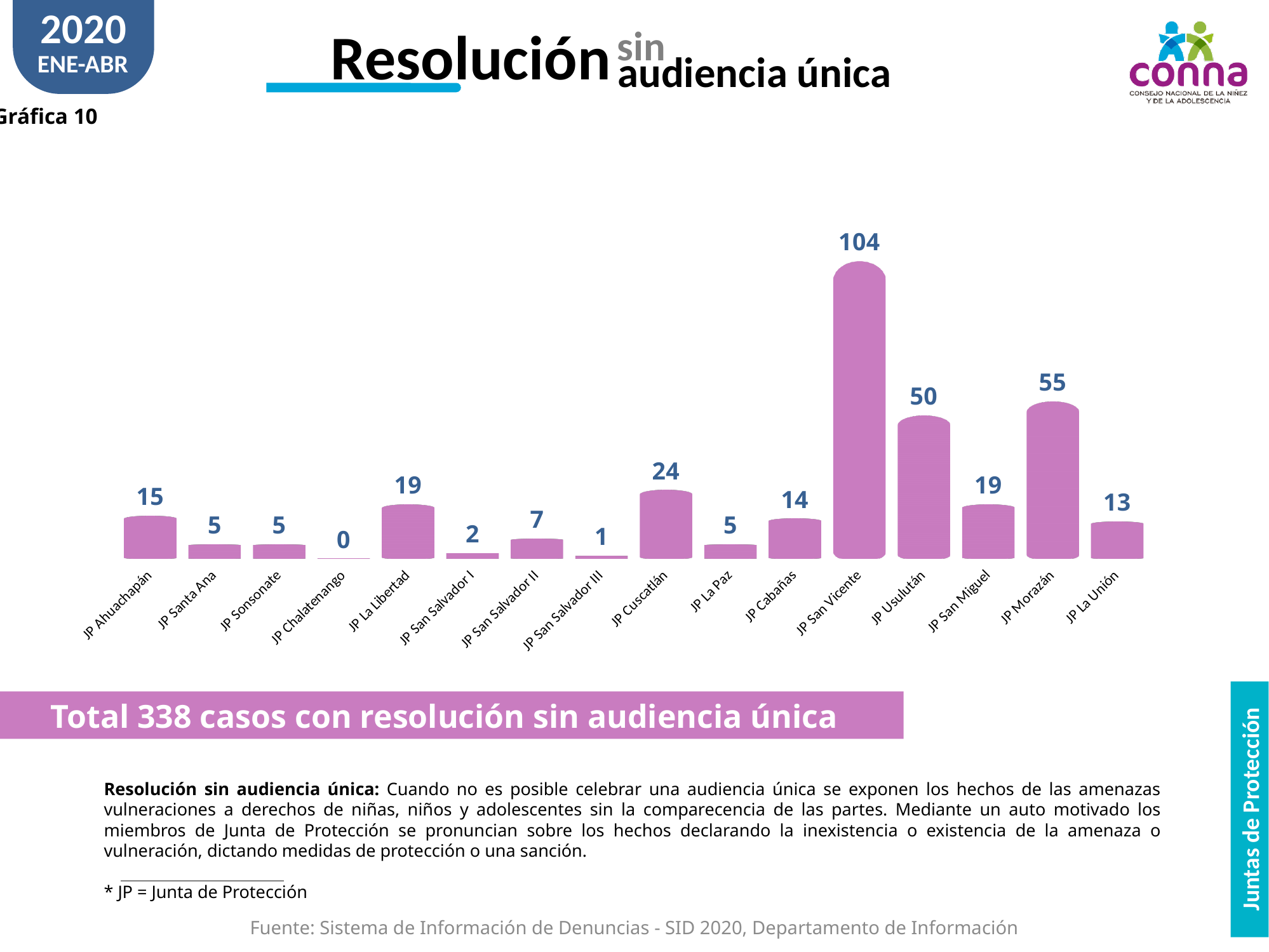
What is the value for JP Chalatenango? 0 Which category has the highest value? JP San Vicente What is the value for JP San Vicente? 104 What is the value for JP Cuscatlán? 24 What is the difference between the values for JP Usulután and JP Cabañas? 36 Which category has the lowest value? JP Chalatenango What is the value for JP La Unión? 13 What kind of chart is shown on the slide? Bar chart What is the difference between the values for JP San Vicente and JP Morazán? 49 Which is larger, the value for JP Morazán or the value for JP Usulután? JP Morazán What total number of cases is stated in the banner below the chart? 338 How many categories are shown on the x axis? 16